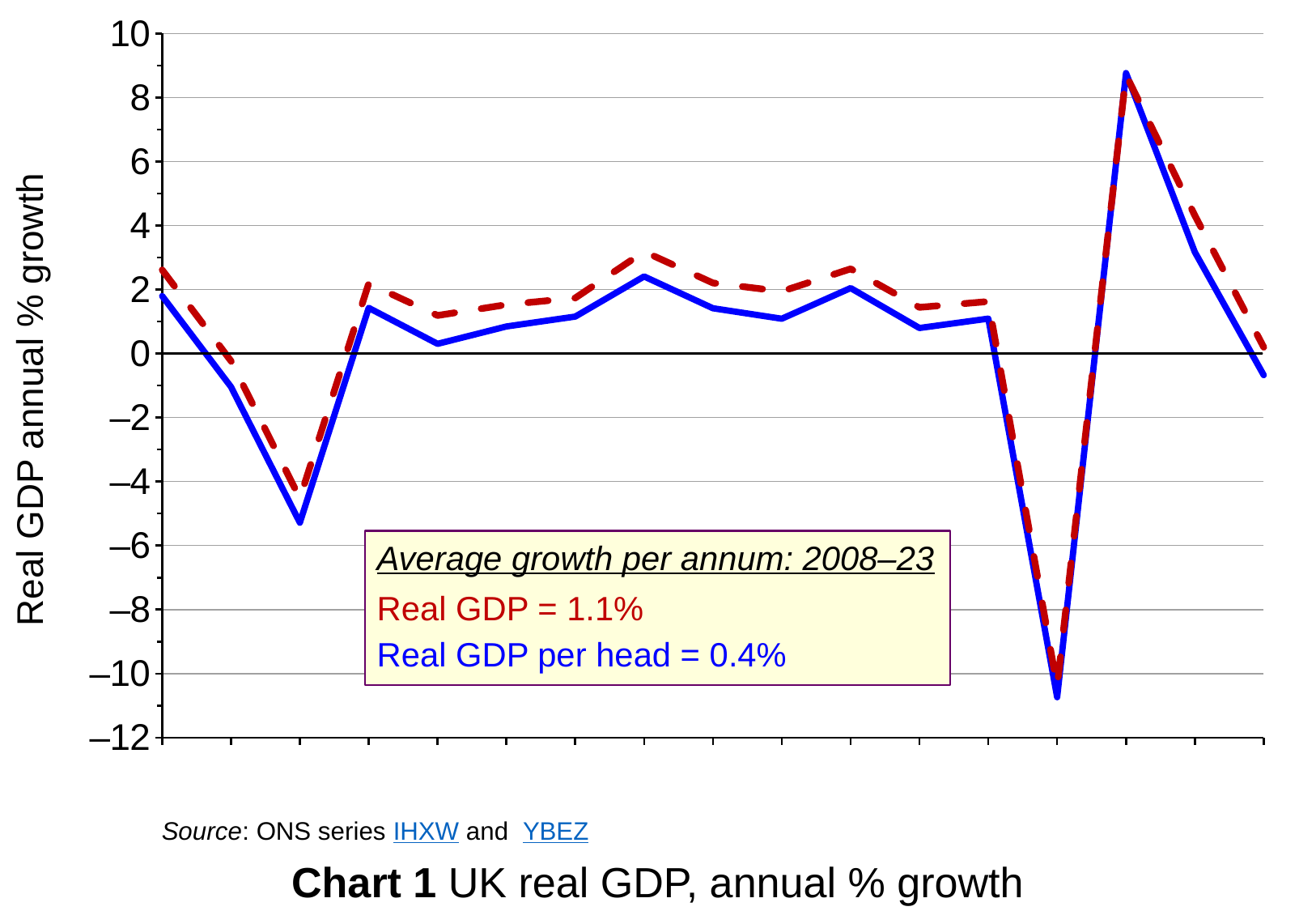
What is the label on the vertical axis? Real GDP annual % growth According to the text box, what is the average growth per annum of Real GDP per head for 2008–23? 0.4% Which has the larger average growth per annum for 2008–23, Real GDP or Real GDP per head? Real GDP What is the title of the chart? Chart 1 UK real GDP, annual % growth Is the lowest value of the solid blue line greater or less than -10? less How many data points does the solid blue line have? 17 How many lines (series) are plotted on the chart? 2 Is the highest value of the dashed red line greater or less than 8? greater What is the difference between the average growth per annum of Real GDP (1.1%) and Real GDP per head (0.4%)? 0.7 percentage points According to the text box, what is the average growth per annum of Real GDP for 2008–23? 1.1% What type of chart is Chart 1? Line chart Is the value at the first trough of the solid blue line greater or less than -4? less